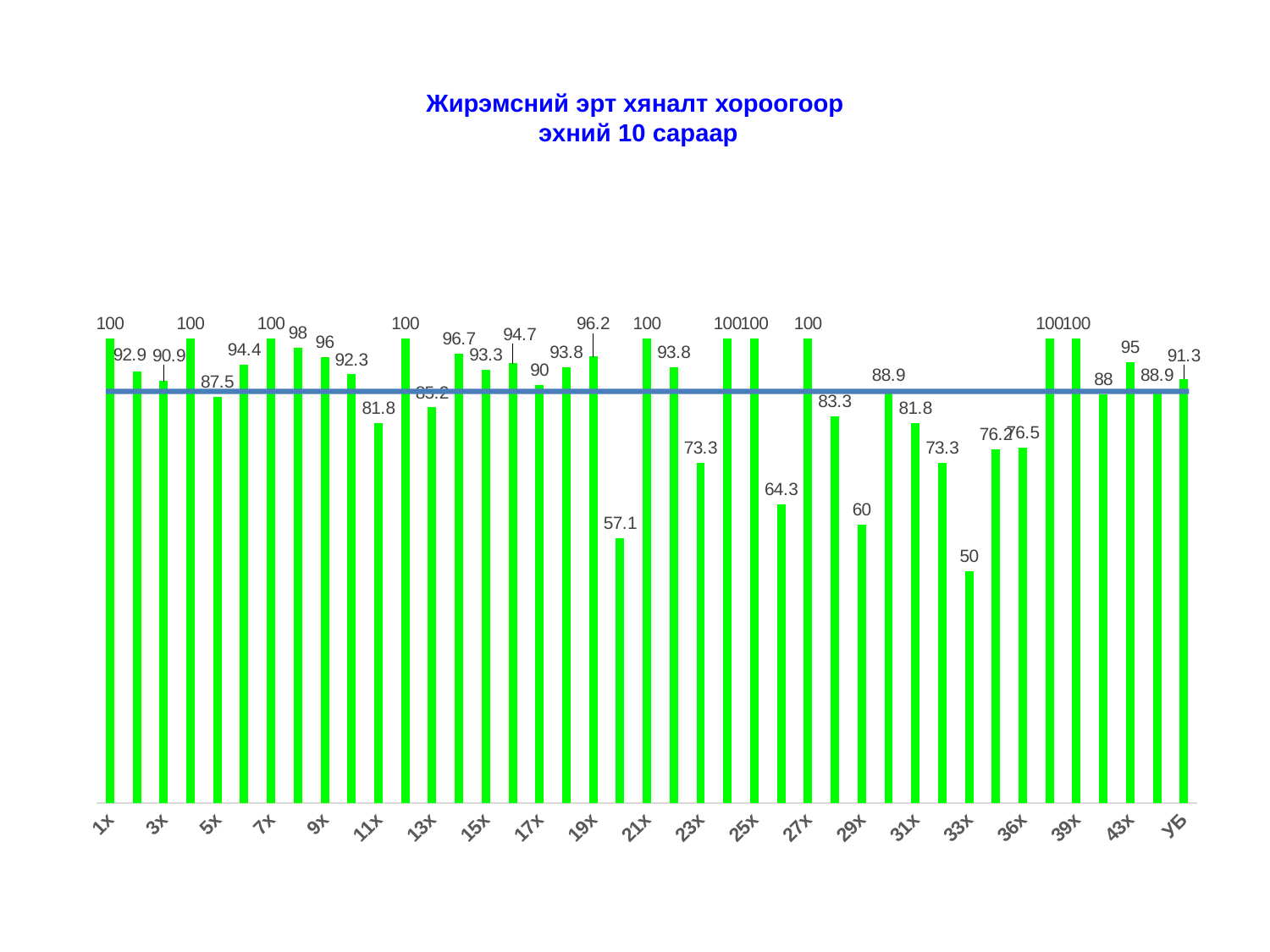
What is the value for 1х? 100 Which is larger, the value for 23х or the value for 29х? 23х What is the value for УБ? 91.3 What is the title of the chart? Жирэмсний эрт хяналт хороогоор эхний 10 сараар Which category has the lowest value? 33х What is the value for 33х? 50 What is the value for 29х? 60 What type of chart is shown on the slide? bar chart What is the value for 43х? 95 What is the difference between the value for 1х and the value for УБ? 8.7 What colour are the bars in the chart? green What is the value for 5х? 87.5